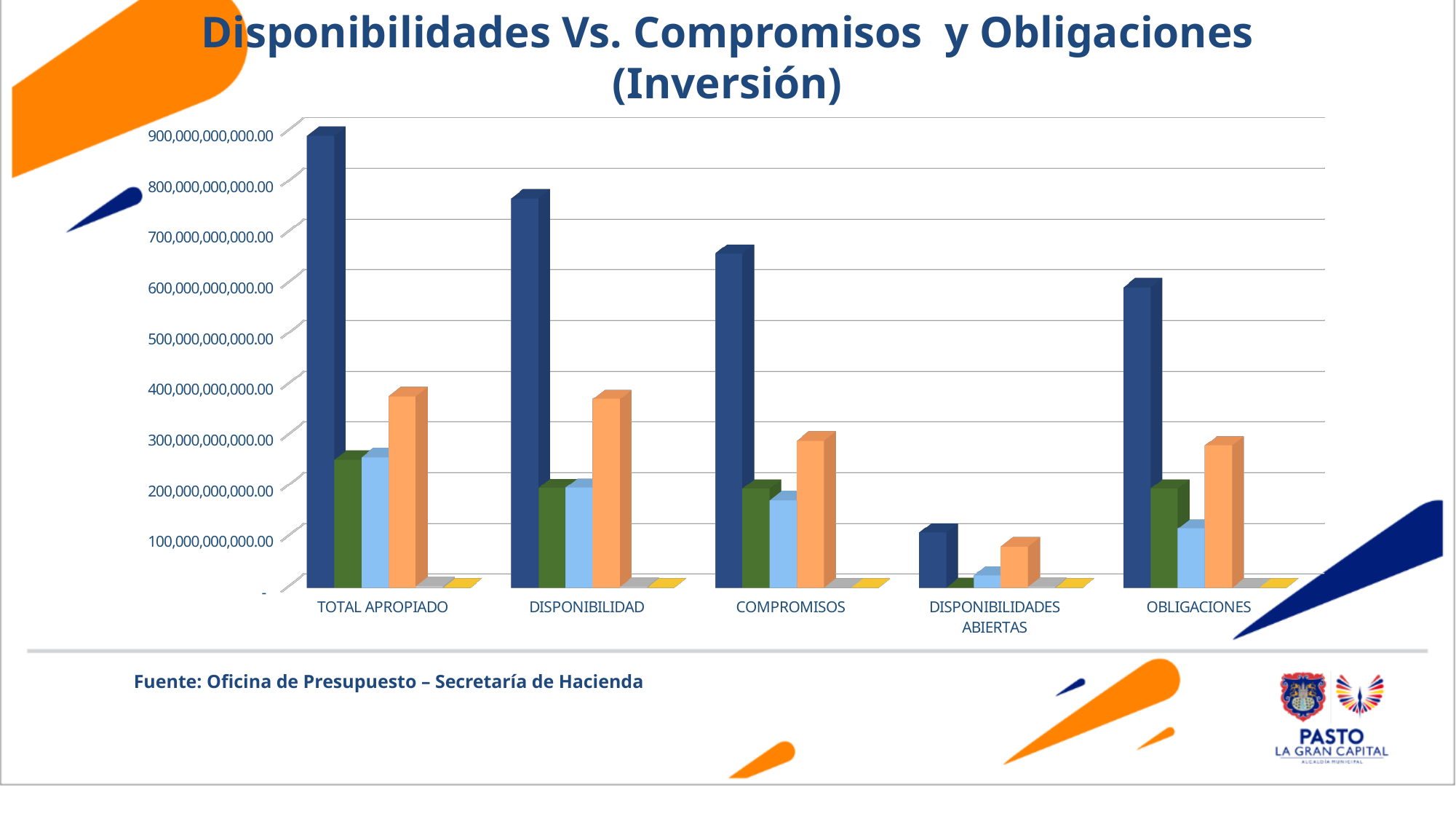
Which has the larger green bar, TOTAL APROPIADO or DISPONIBILIDAD? TOTAL APROPIADO Which category has the shortest orange bar? DISPONIBILIDADES ABIERTAS What is the title of the chart? Disponibilidades Vs. Compromisos y Obligaciones (Inversión) Which category has the tallest dark blue bar? TOTAL APROPIADO How many differently coloured bars are plotted for each category? 6 Is the orange bar for DISPONIBILIDADES ABIERTAS greater or less than 100,000,000,000.00? less How many categories are shown along the x axis of the chart? 5 Which category has the shortest dark blue bar? DISPONIBILIDADES ABIERTAS Is the dark blue bar for TOTAL APROPIADO greater or less than 800,000,000,000.00? greater Which has the larger dark blue bar, TOTAL APROPIADO or DISPONIBILIDAD? TOTAL APROPIADO What kind of chart is shown on the slide? bar chart Is the dark blue bar for COMPROMISOS greater or less than 600,000,000,000.00? greater